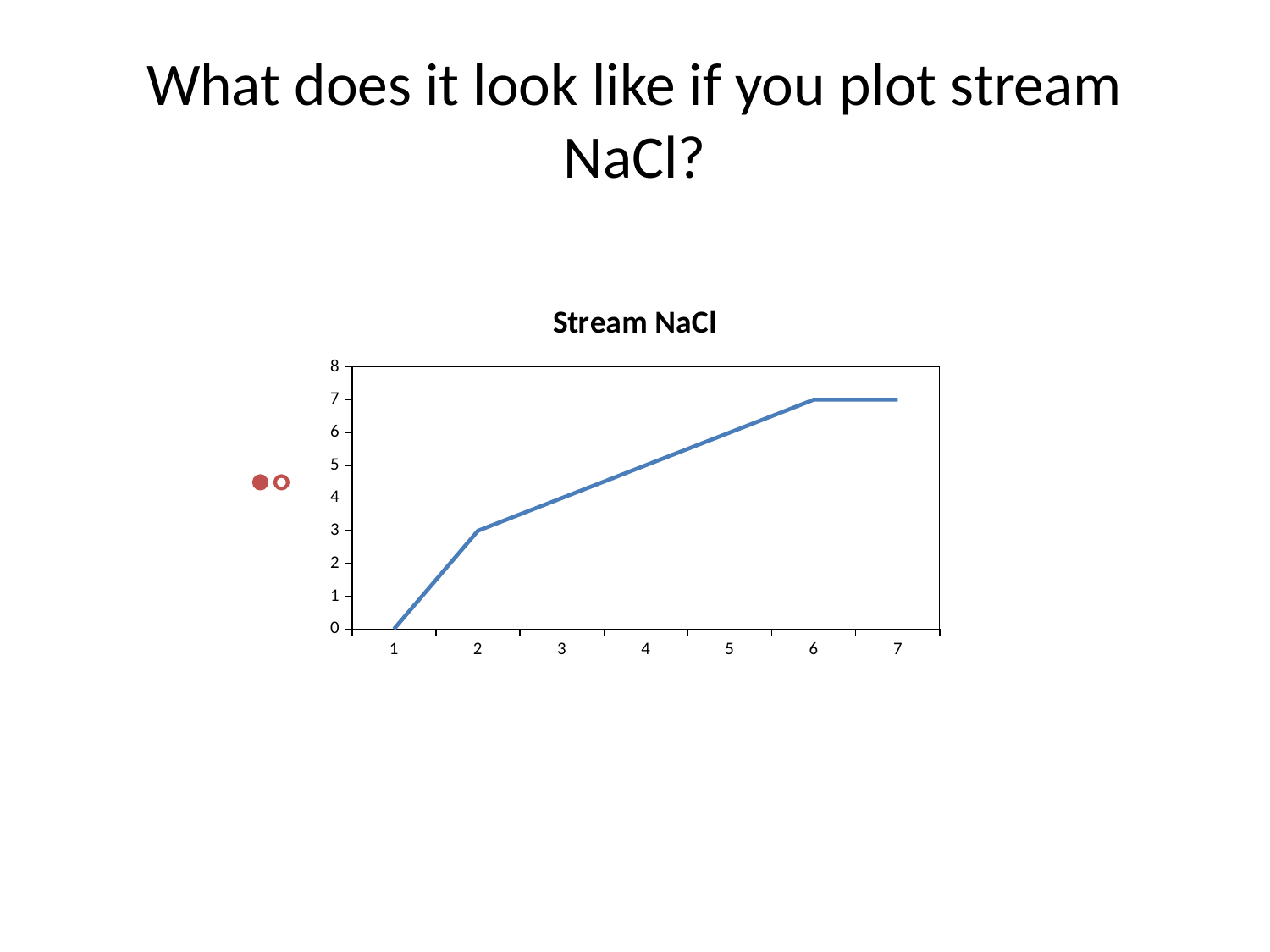
What is the difference between the value at x = 6 and the value at x = 2? 4 What is the value at x = 2? 3 What is the value at x = 6? 7 What is the value at x = 7? 7 How many data points are plotted on the line? 7 What is the title of the chart? Stream NaCl What is the value at x = 1? 0 Is the value at x = 5 greater or less than 4? greater What kind of chart is shown on the slide? line chart Which is larger, the value at x = 4 or the value at x = 2? x = 4 At which x value is the plotted value lowest? 1 Do the values rise or fall as x increases from 1 to 6? rise